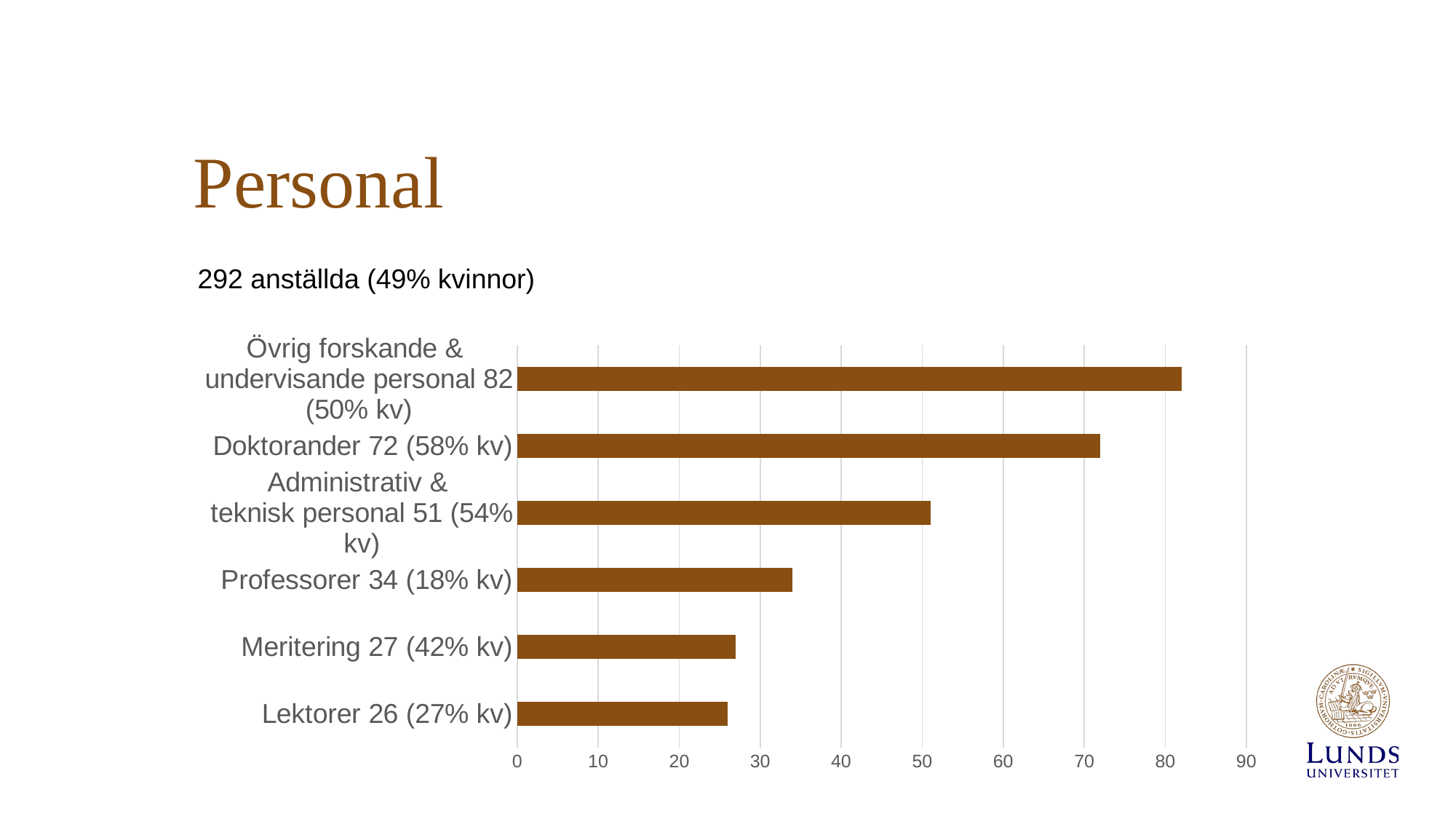
What is the difference between the values for Doktorander and Administrativ & teknisk personal? 21 What is the value for Lektorer? 26 What percentage of women (kv) is given for Professorer? 18% Which is larger, the value for Meritering or the value for Professorer? Professorer How many categories does the bar chart show? 6 What is the total number of employees stated on the slide? 292 Which category has the lowest value? Lektorer What kind of chart is shown on the slide? Bar chart Which category has the highest value? Övrig forskande & undervisande personal What is the value for Doktorander? 72 What is the value for Professorer? 34 Is the value for Administrativ & teknisk personal greater or less than 60? less